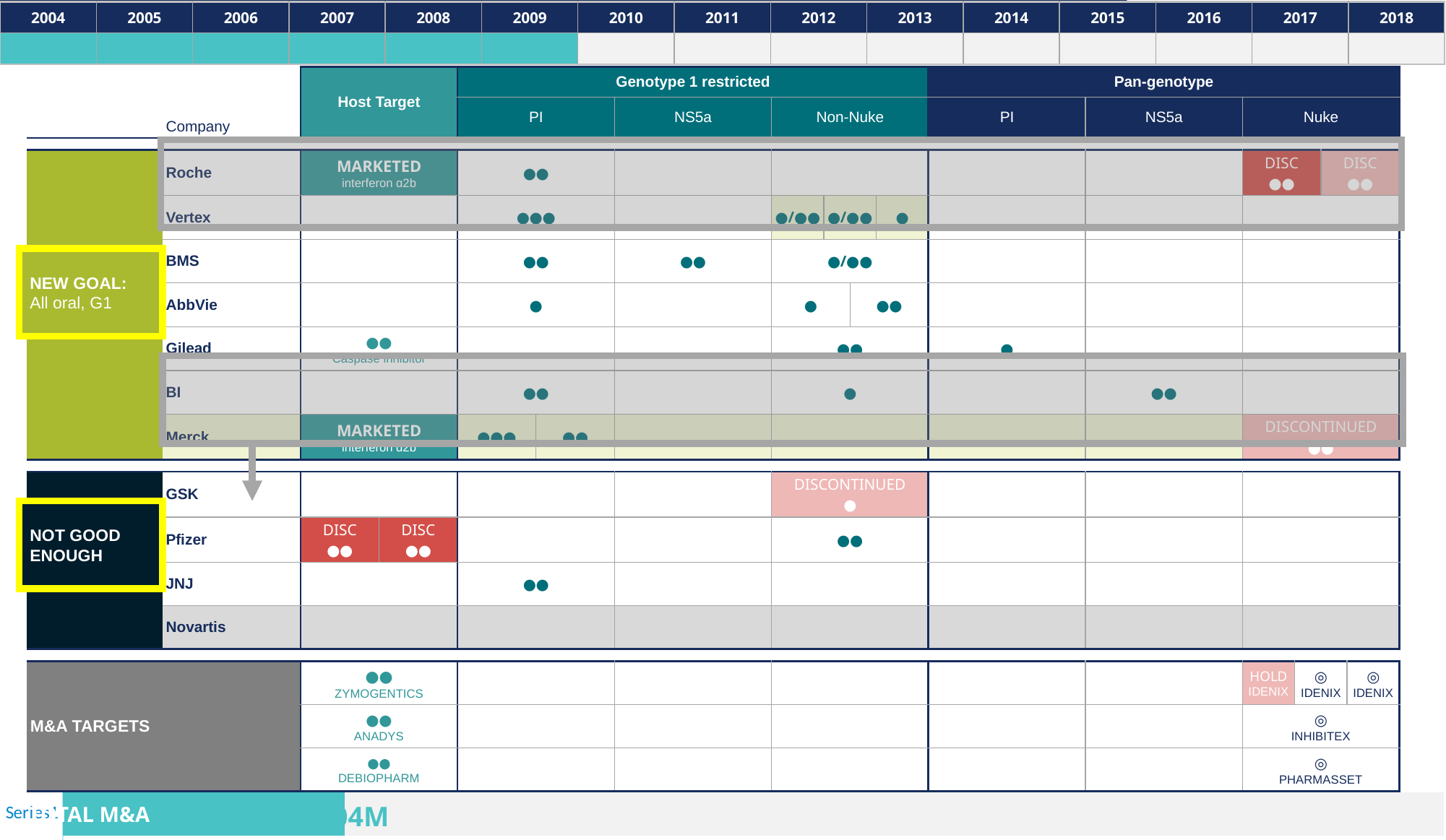
On the timeline chart at the top of the slide, how many years does the teal shaded bar cover? 6 On the timeline chart at the top of the slide, what is the last year covered by the teal shaded bar? 2009 On the timeline chart at the top of the slide, how many year labels are shown along the axis? 15 On the chart at the bottom of the slide next to 'TOTAL M&A', what is the legend entry shown? Series1 On the timeline chart at the top of the slide, what is the first year shown on the axis? 2004 On the timeline chart at the top of the slide, what is the last year shown on the axis? 2018